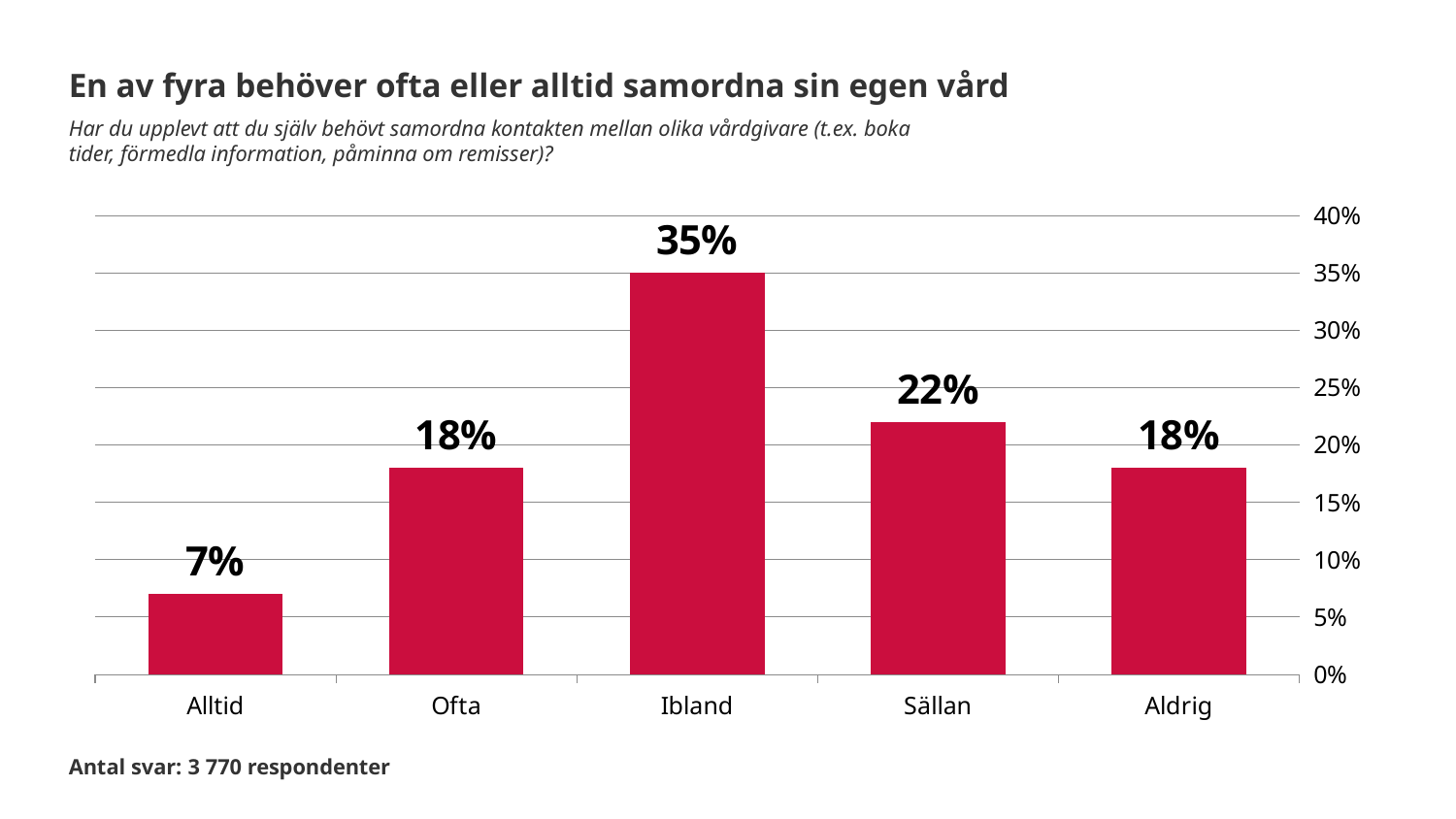
Which is larger, the value for Sällan or the value for Aldrig? Sällan What is the value for Ibland? 35% What kind of chart is shown on the slide? Bar chart Is the value for Ibland greater or less than 30%? greater Which category has the lowest value? Alltid What is the value for Sällan? 22% What is the difference between the values for Ibland and Sällan? 13% What is the difference between the values for Ofta and Alltid? 11% What is the value for Alltid? 7% How many categories are shown on the x axis? 5 What is the title of the chart on the slide? En av fyra behöver ofta eller alltid samordna sin egen vård Which category has the highest value? Ibland